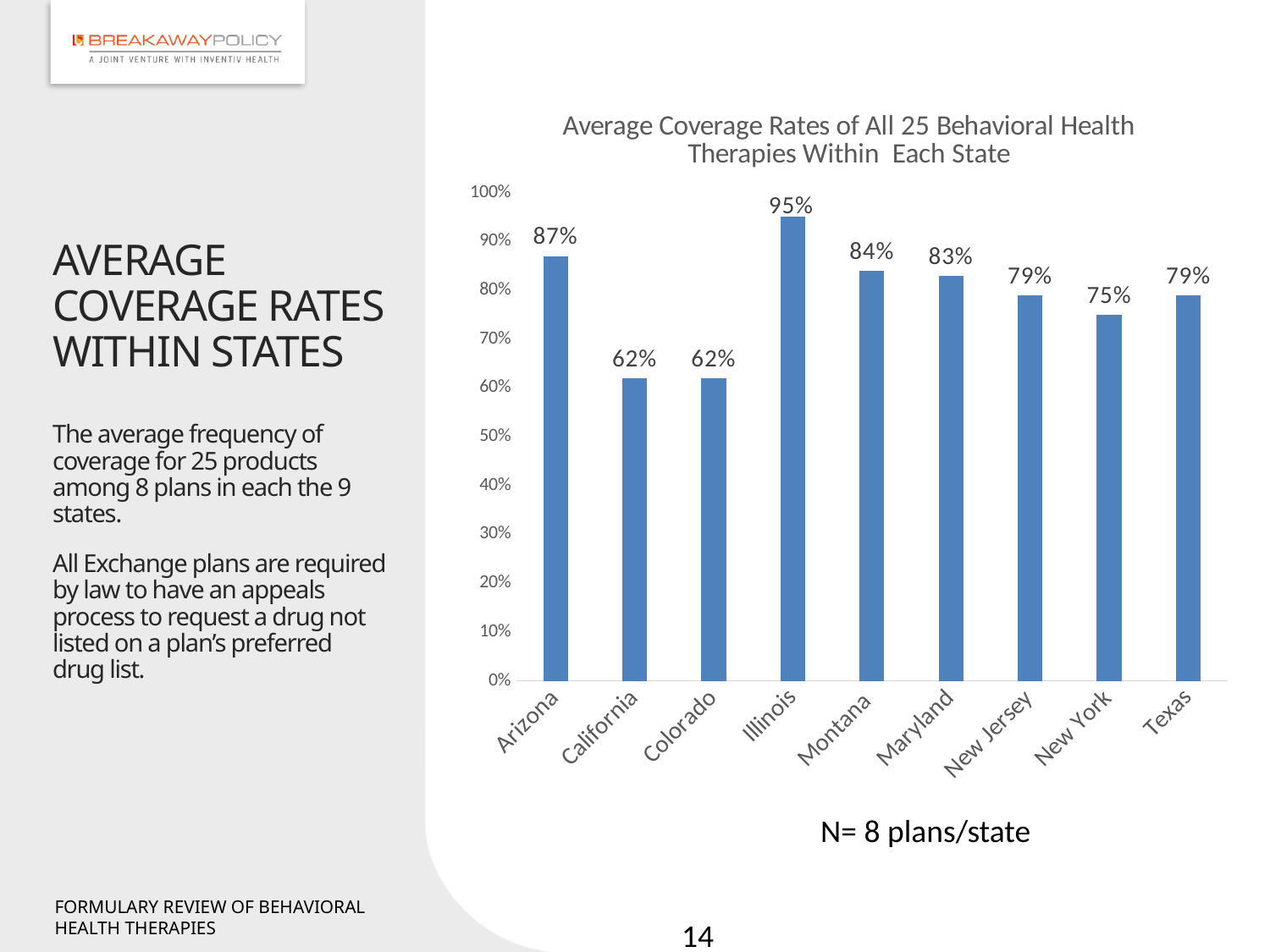
Which has a higher average coverage rate, Montana or Maryland? Montana Which state has the highest average coverage rate? Illinois Which two states share the lowest average coverage rate? California and Colorado What is the difference between the coverage rates for Illinois and New York? 20% What is the average coverage rate for New York? 75% What is the average coverage rate for Texas? 79% What is the difference between the coverage rates for Arizona and California? 25% What is the title of the chart? Average Coverage Rates of All 25 Behavioral Health Therapies Within Each State What is the average coverage rate for Illinois? 95% How many states are shown on the chart? 9 What kind of chart is shown on the slide? bar chart Is the value for Colorado greater or less than 70%? less